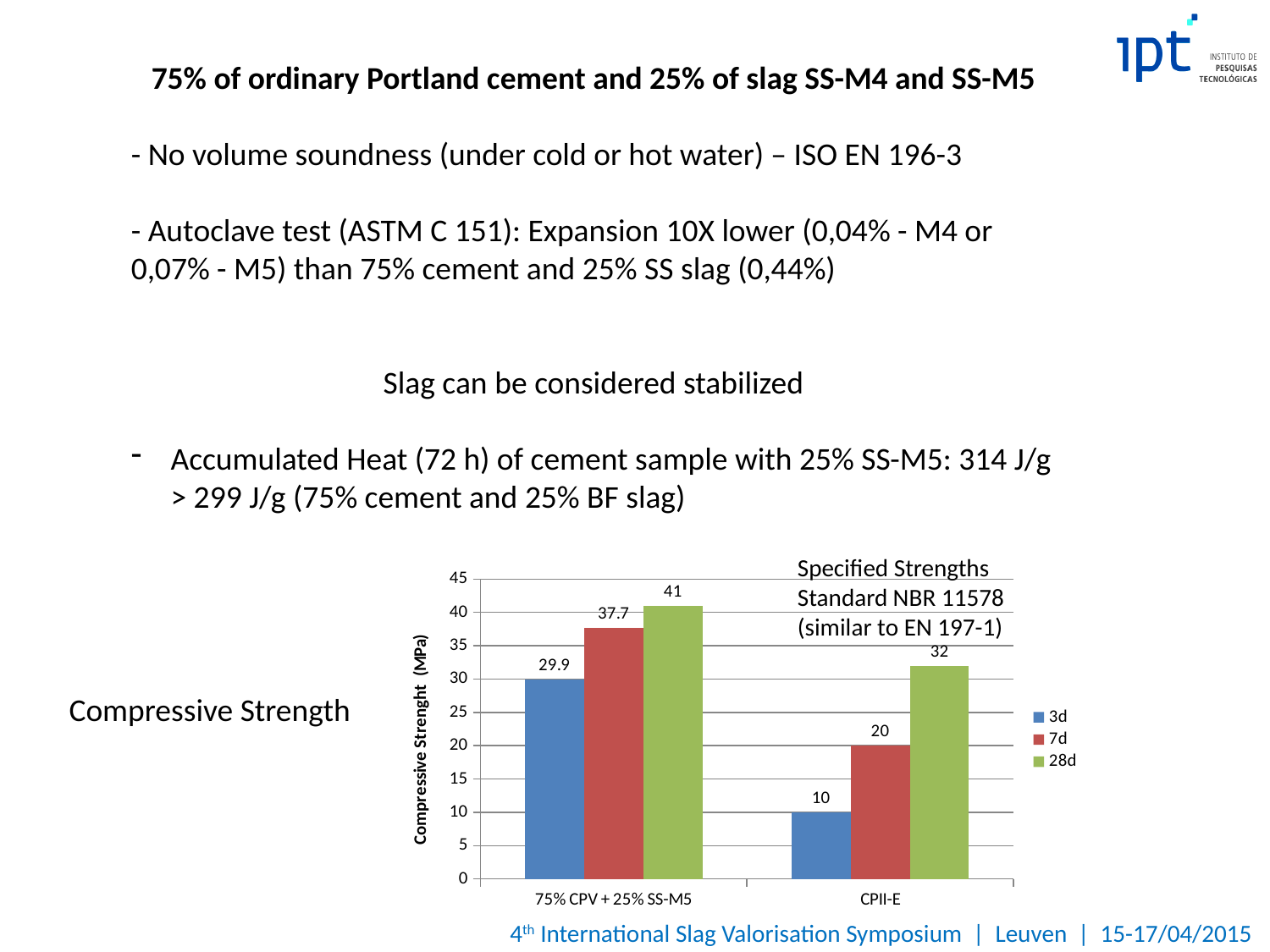
What is the 7d compressive strength for 75% CPV + 25% SS-M5? 37.7 What is the 3d compressive strength for CPII-E? 10 Which category has the lowest 3d compressive strength? CPII-E Which is larger: the 7d value for 75% CPV + 25% SS-M5 or the 7d value for CPII-E? 75% CPV + 25% SS-M5 What is the label of the y axis of the chart? Compressive Strenght (MPa) How many series does the chart legend list? 3 How many categories are shown on the x axis of the chart? 2 What is the difference between the 28d compressive strength of 75% CPV + 25% SS-M5 and CPII-E? 9 What is the 28d compressive strength for CPII-E? 32 What is the 3d compressive strength for 75% CPV + 25% SS-M5? 29.9 Which category has the highest 28d compressive strength? 75% CPV + 25% SS-M5 What kind of chart is shown on the slide? bar chart